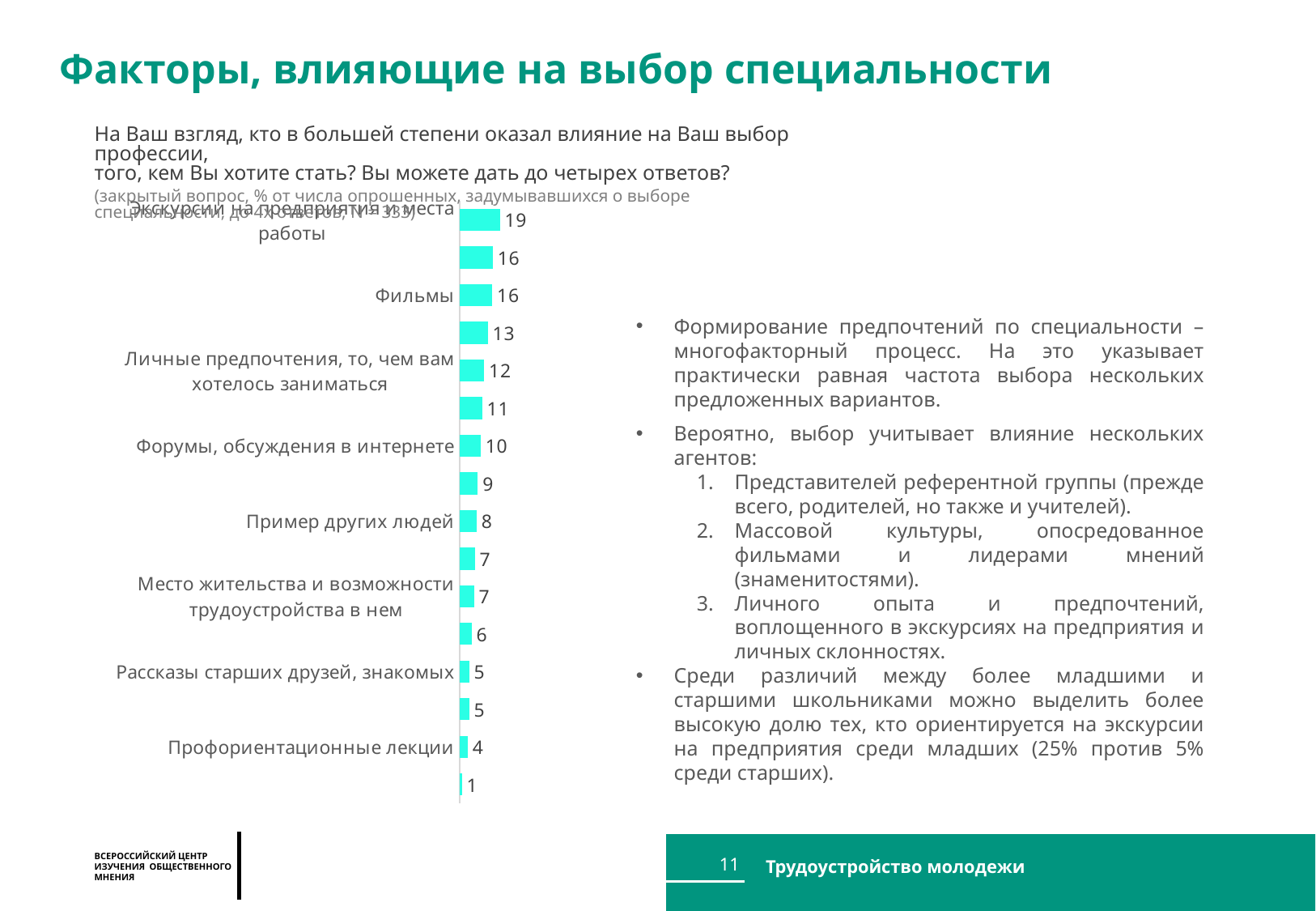
Which has a larger value: "Форумы, обсуждения в интернете" or "Пример других людей"? Форумы, обсуждения в интернете What value is shown for "Профориентационные лекции"? 4 What value is shown for "Место жительства и возможности трудоустройства в нем"? 7 What is the smallest value shown on any bar in the chart? 1 Which labelled category has the highest value in the chart? Экскурсии на предприятия и места работы What value is shown for "Рассказы старших друзей, знакомых"? 5 What value is shown for "Личные предпочтения, то, чем вам хотелось заниматься"? 12 What value is shown for "Пример других людей"? 8 What value is shown for "Форумы, обсуждения в интернете"? 10 What value is shown for "Фильмы"? 16 What kind of chart is shown on the slide? Bar chart What is the difference between the values for "Фильмы" and "Профориентационные лекции"? 12